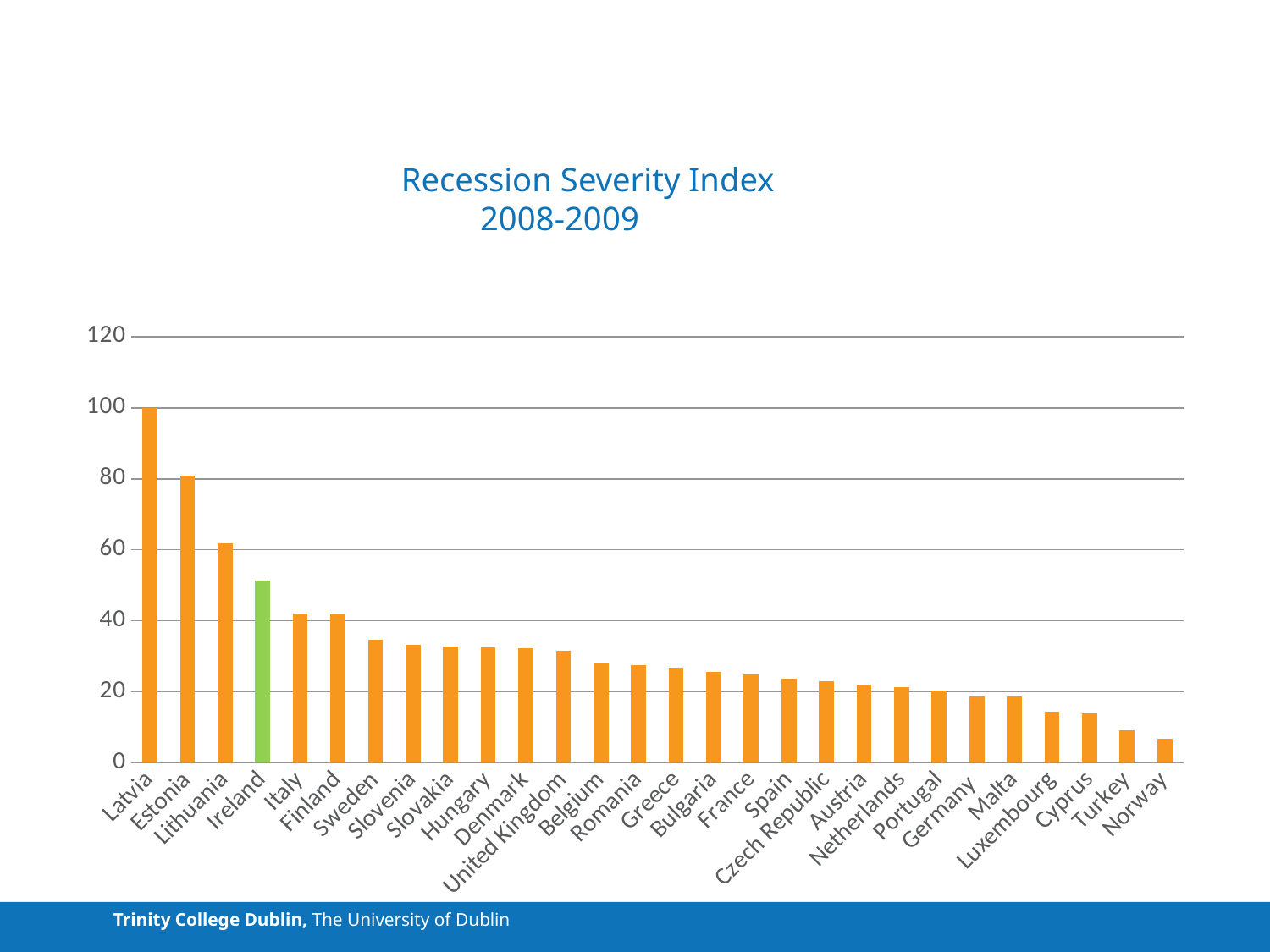
Which country's bar is coloured green rather than orange? Ireland Is the value for Norway greater or less than 20? less What kind of chart is shown on the slide? bar chart Is the value for Ireland greater or less than 60? less Which country has the highest Recession Severity Index? Latvia Do the values rise or fall moving from left to right along the x axis? fall How many countries are shown on the chart? 28 Which country has the lowest Recession Severity Index? Norway What is the title of the chart? Recession Severity Index 2008-2009 What is the Recession Severity Index value for Latvia? 100 Is the value for Ireland greater or less than 40? greater Which has a higher Recession Severity Index, Estonia or Lithuania? Estonia